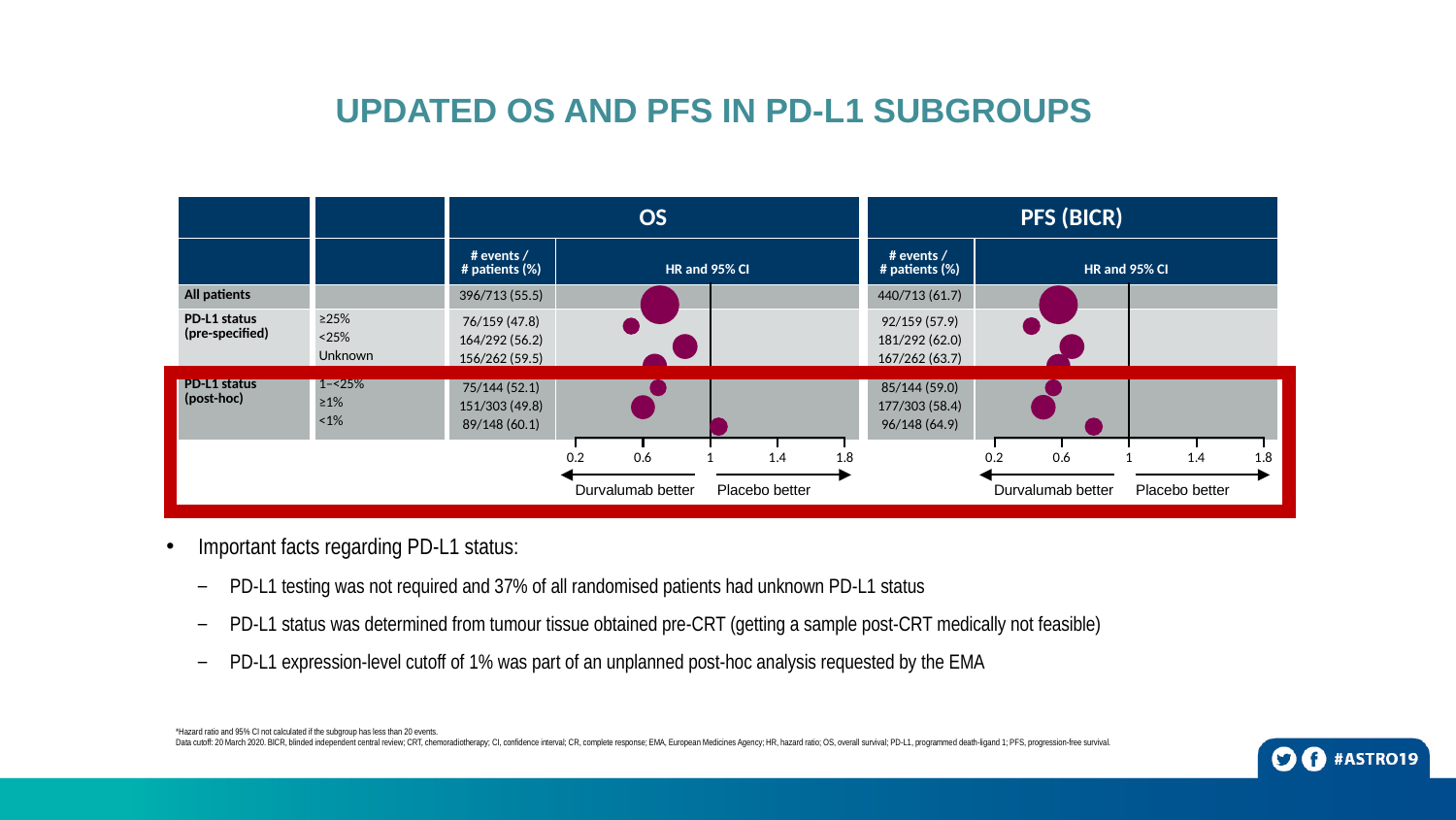
In the PFS (BICR) panel, is the hazard ratio for PD-L1 <1% greater or less than 1? less In the PFS (BICR) panel, is the hazard ratio for All patients greater or less than 1? less In the PFS (BICR) panel, is the hazard ratio for PD-L1 ≥25% greater or less than 0.6? less How many patient groups (rows) are plotted in the OS forest plot? 7 What kind of chart is used to display the HR and 95% CI values on this slide? forest plot In the OS panel, which subgroup has the larger hazard ratio: PD-L1 ≥25% or PD-L1 <1%? PD-L1 <1% What is the OS # events / # patients (%) value for All patients? 396/713 (55.5) What is the OS # events / # patients (%) value for the PD-L1 ≥25% subgroup? 76/159 (47.8) What is the PFS (BICR) # events / # patients (%) value for the PD-L1 <1% subgroup? 96/148 (64.9) What label appears under the left-pointing arrow beneath each forest plot? Durvalumab better